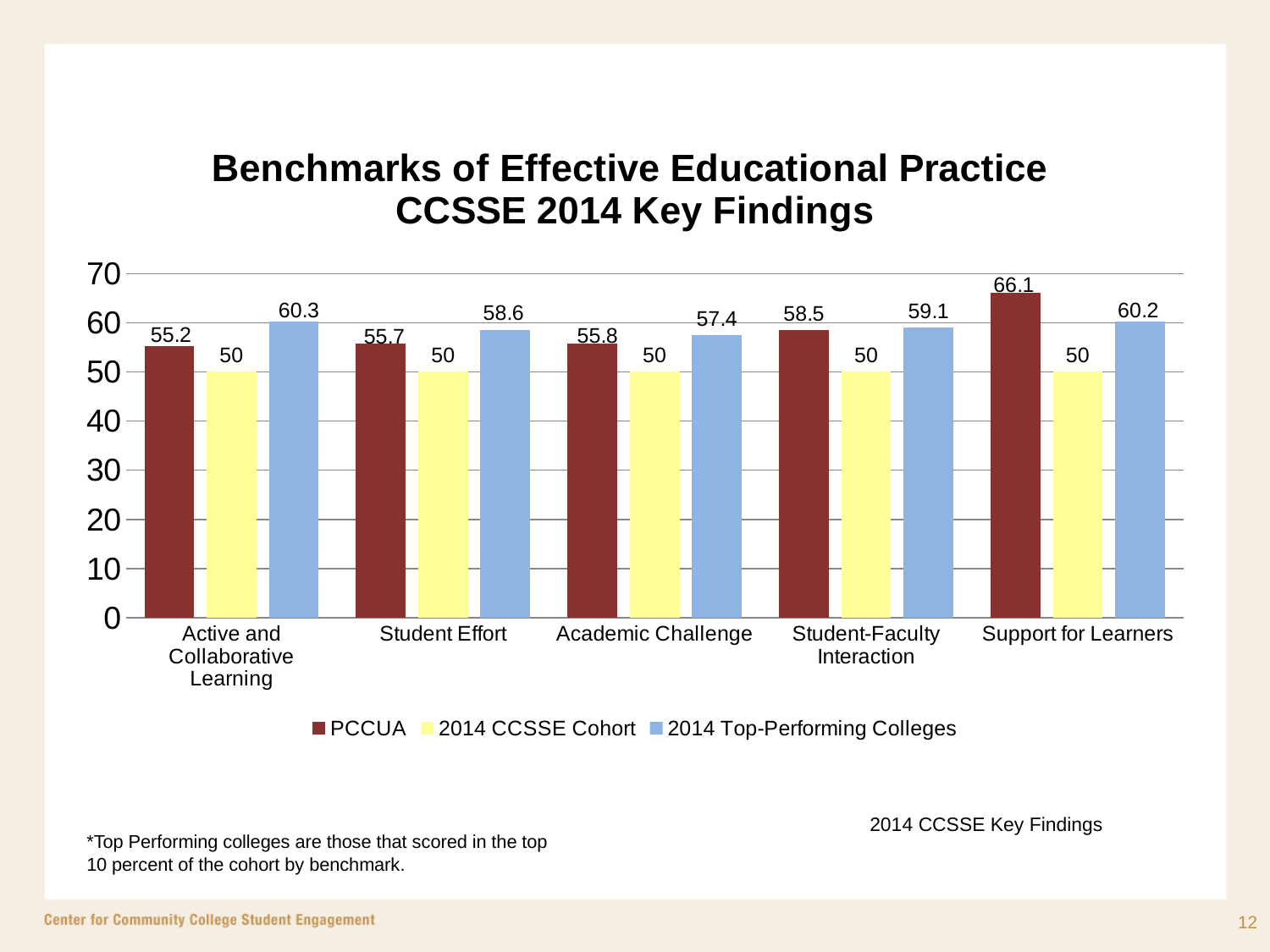
What kind of chart is shown on the slide? Bar chart How many benchmark categories are shown on the x axis? 5 Which benchmark has the lowest PCCUA value? Active and Collaborative Learning Which benchmark has the highest PCCUA value? Support for Learners How many series does the legend list? 3 Which is larger for Support for Learners: the PCCUA value or the 2014 Top-Performing Colleges value? PCCUA What is the PCCUA value for Student-Faculty Interaction? 58.5 What is the 2014 Top-Performing Colleges value for Academic Challenge? 57.4 What value does the 2014 CCSSE Cohort series have for every benchmark? 50 What is the difference between the 2014 Top-Performing Colleges value and the PCCUA value for Active and Collaborative Learning? 5.1 Which is larger for Student Effort: the PCCUA value or the 2014 Top-Performing Colleges value? 2014 Top-Performing Colleges What is the PCCUA value for Support for Learners? 66.1